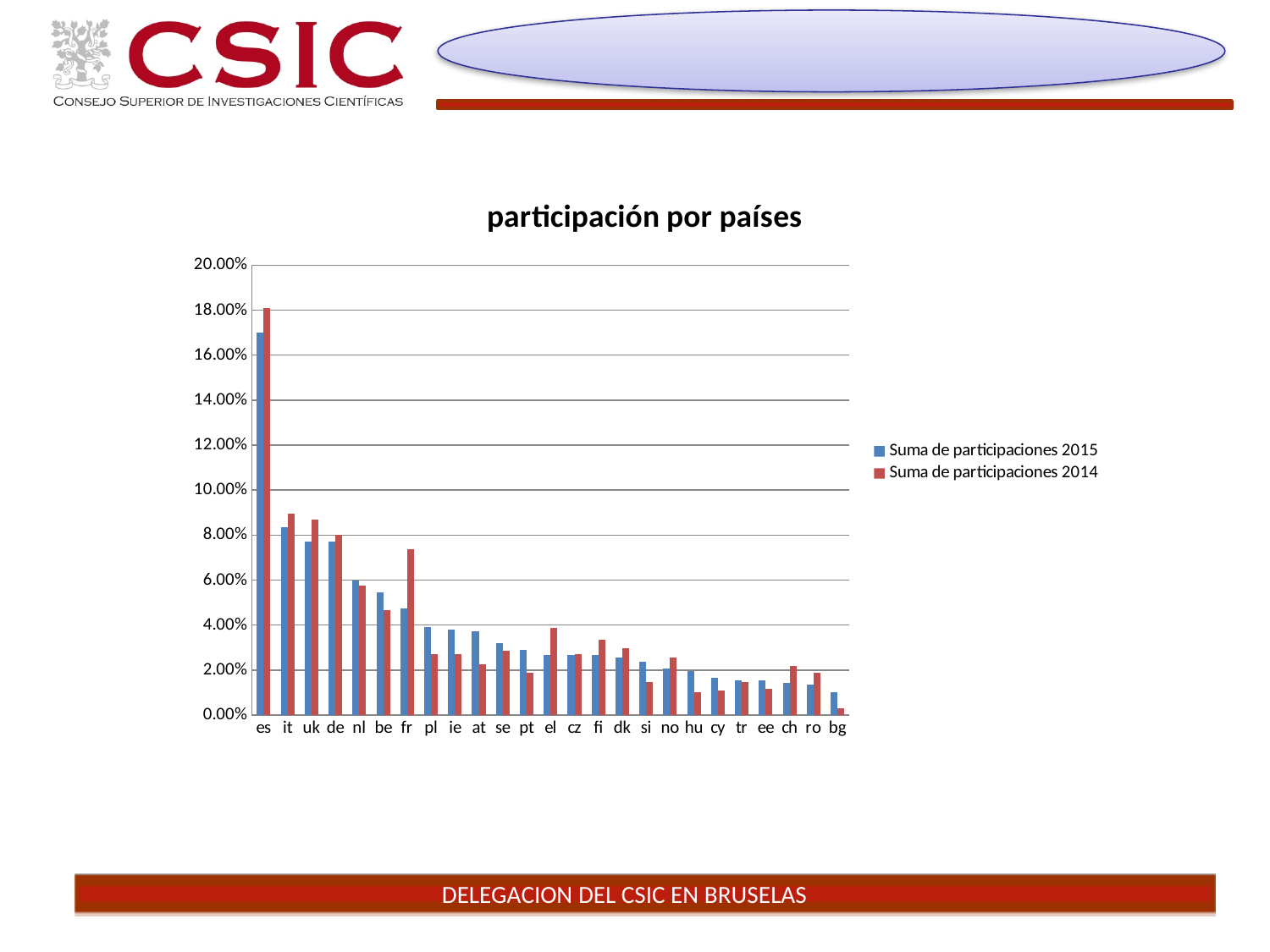
What kind of chart is shown on the slide? bar chart How many countries are shown on the x axis? 25 For hu, which series has the larger value: Suma de participaciones 2015 or Suma de participaciones 2014? Suma de participaciones 2015 Which country has the highest value for Suma de participaciones 2015? es Is the value for es in Suma de participaciones 2015 greater or less than 16.00%? greater What is the title of the chart? participación por países How many series does the legend list? 2 Is the value for be in Suma de participaciones 2015 greater or less than 6.00%? less Is the value for fr in Suma de participaciones 2014 greater or less than 6.00%? greater Which country has the lowest value for Suma de participaciones 2014? bg Do the values for Suma de participaciones 2015 generally rise or fall from left to right along the x axis? fall For fr, which series has the larger value: Suma de participaciones 2015 or Suma de participaciones 2014? Suma de participaciones 2014